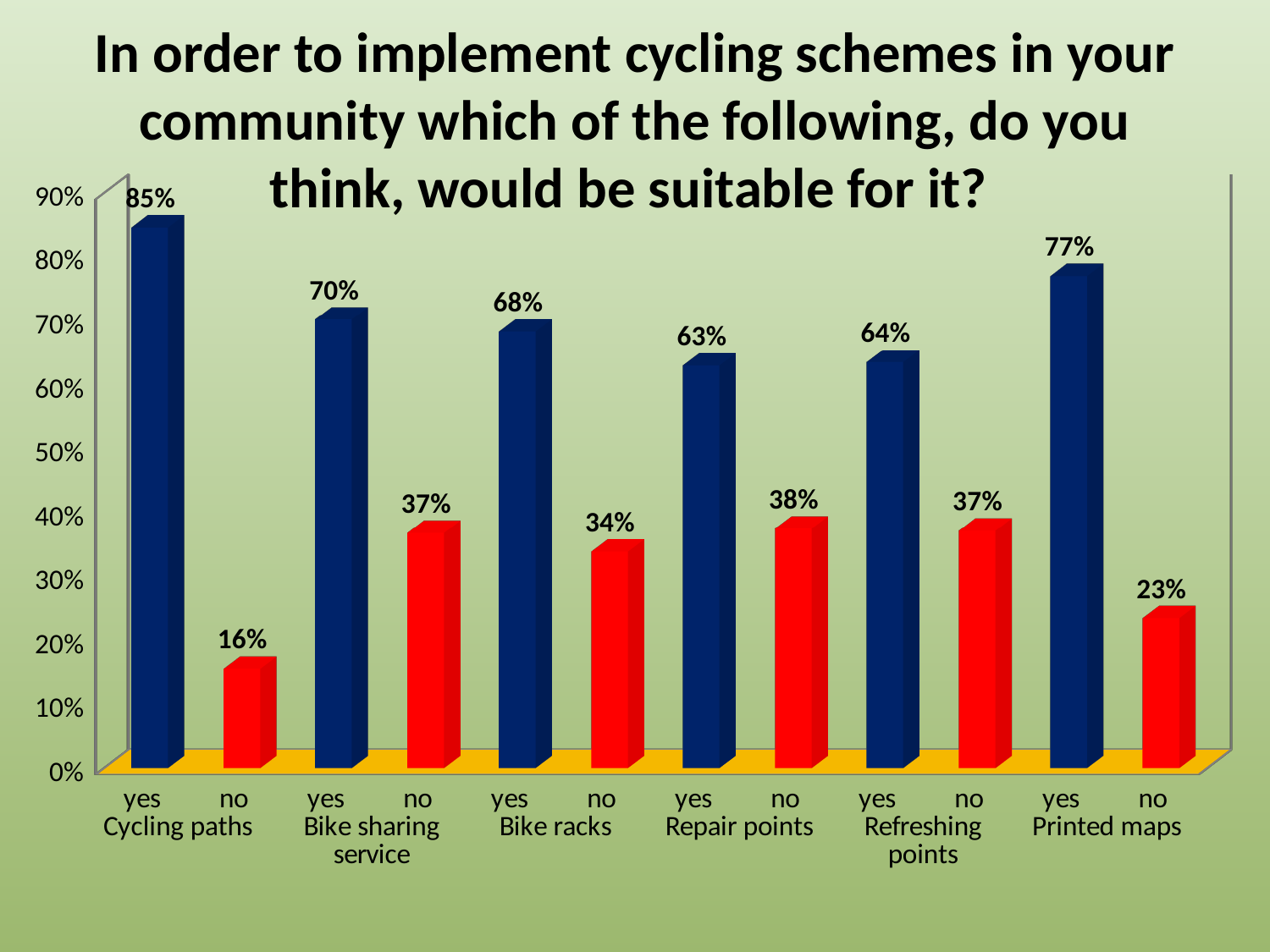
What is the yes value for repair points? 63% What is the difference between the yes values for cycling paths and printed maps? 8% Which is larger, the yes value for bike racks or the yes value for refreshing points? Bike racks What percentage of respondents said no to printed maps? 23% Is the no value for repair points greater or less than 30%? greater How many options (categories) are shown on the chart? 6 What percentage of respondents said yes to cycling paths? 85% Which option has the lowest no percentage? Cycling paths What kind of chart is shown on the slide? Bar chart What colour are the bars representing 'no' responses? Red What is the difference between the yes and no values for bike sharing service? 33% Which option has the highest yes percentage? Cycling paths